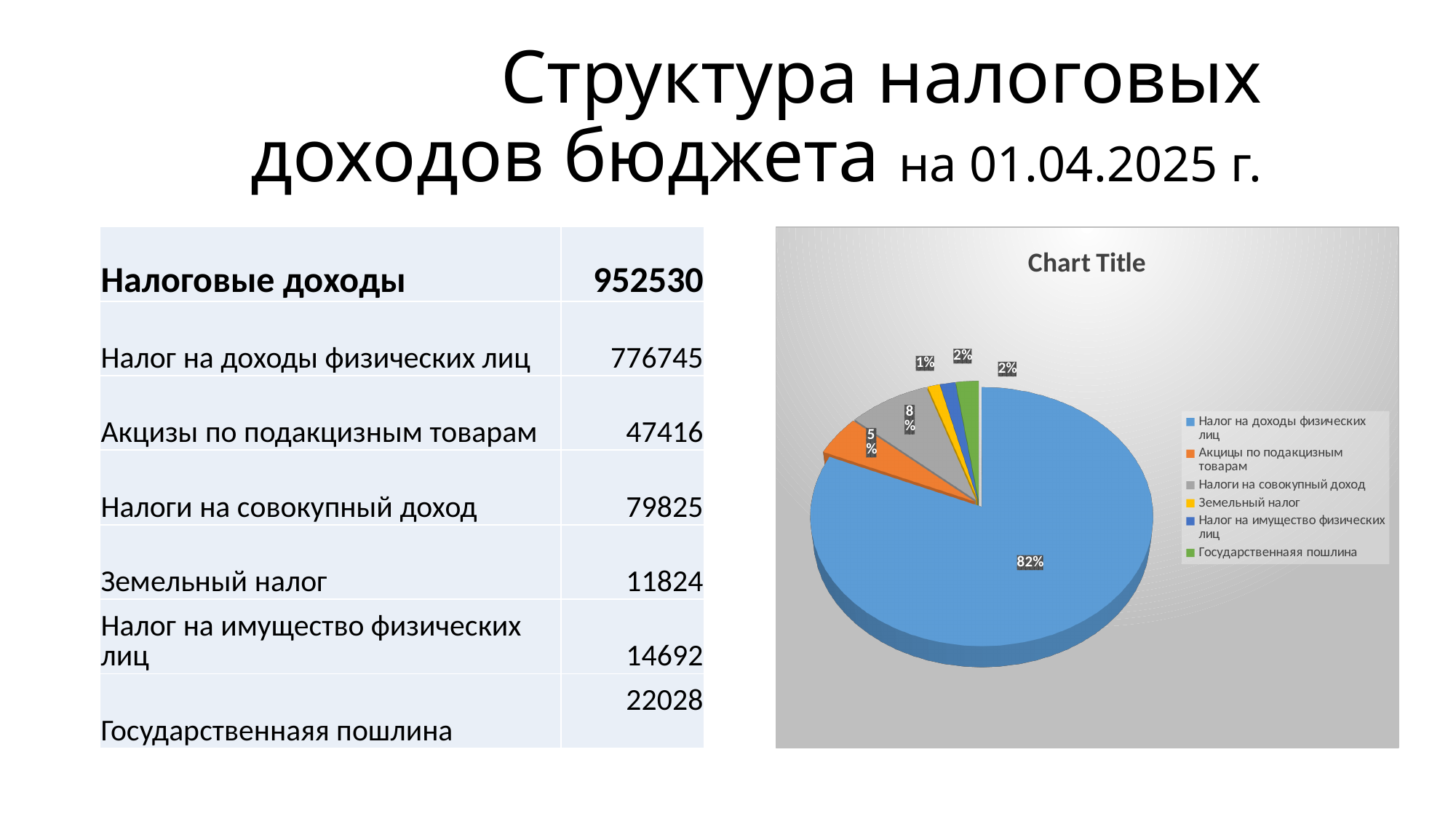
How many entries does the chart legend list? 6 How many slices does the pie chart have? 6 Which category has the largest slice of the pie? Налог на доходы физических лиц What share of the pie does Налог на доходы физических лиц take? 82% What kind of chart is shown on the slide? Pie chart What percentage is shown for Земельный налог? 1% What is the difference in percentage points between Налог на доходы физических лиц and Налоги на совокупный доход? 74% What percentage is shown for Налоги на совокупный доход? 8% Which slice is larger: Налоги на совокупный доход or Акцицы по подакцизным товарам? Налоги на совокупный доход What is the title shown on the chart? Chart Title What percentage is shown for Акцицы по подакцизным товарам? 5% Which category has the smallest slice of the pie? Земельный налог